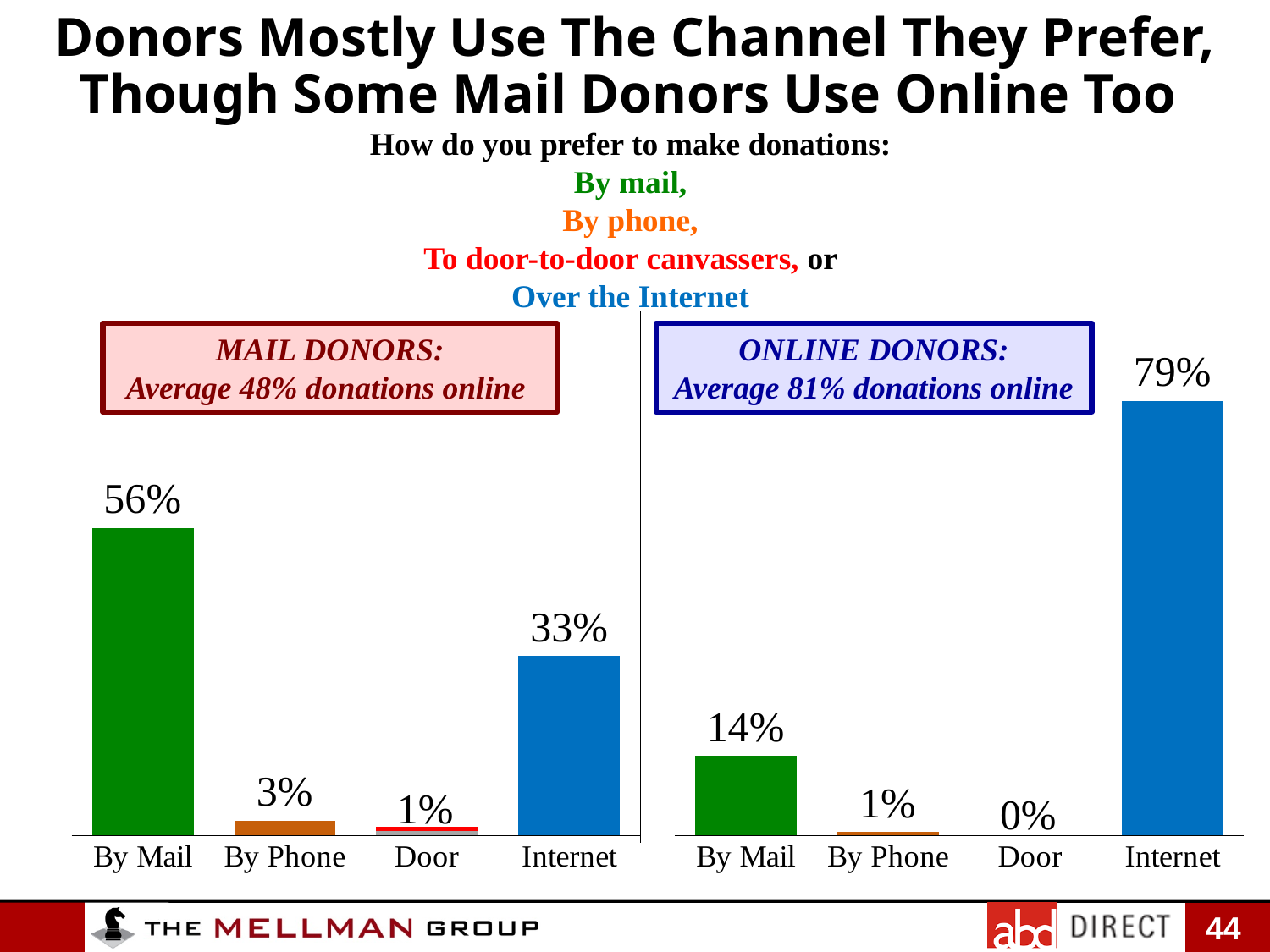
In the Mail Donors chart, what is the difference between the By Mail and Internet values? 23% In the Mail Donors chart, which channel has the highest value? By Mail How many channel categories are shown in the Online Donors chart? 4 In the Online Donors chart, what is the difference between the Internet and By Mail values? 65% In the Mail Donors chart, what is the value for Door? 1% In the Mail Donors chart, what is the value for Internet? 33% In the Online Donors chart, what percentage prefer to donate over the Internet? 79% In the Online Donors chart, which channel has the lowest value? Door In the Online Donors chart, what is the value for By Mail? 14% Which is larger: the Internet value in the Mail Donors chart or the Internet value in the Online Donors chart? Online Donors In the Mail Donors chart, what percentage prefer to donate by mail? 56% What type of chart is the Mail Donors chart? Bar chart